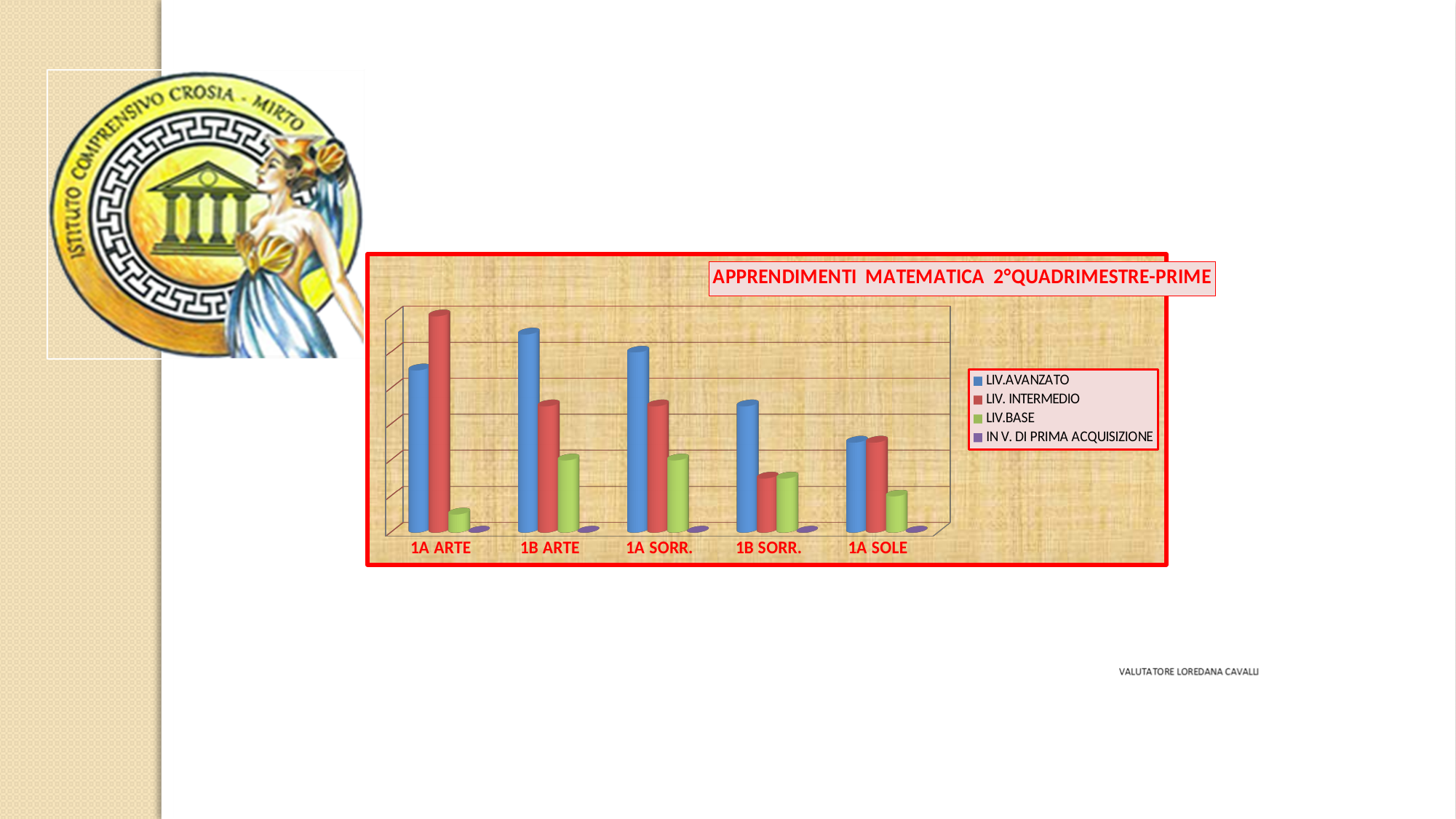
For 1B ARTE, which is larger: LIV.AVANZATO or LIV. INTERMEDIO? LIV.AVANZATO Which class has the shortest LIV.AVANZATO bar? 1A SOLE Which class has the tallest LIV.AVANZATO bar? 1B ARTE What kind of chart is shown on the slide? bar chart Which class has the shortest LIV. INTERMEDIO bar? 1B SORR. What is the title of the chart? APPRENDIMENTI MATEMATICA 2°QUADRIMESTRE-PRIME How many series does the chart legend list? 4 How many categories (classes) are shown on the x axis of the chart? 5 Which class has the shortest LIV.BASE bar? 1A ARTE Which series is shown in green in the chart? LIV.BASE Which class has the tallest LIV. INTERMEDIO bar? 1A ARTE For 1A ARTE, which is larger: LIV.AVANZATO or LIV. INTERMEDIO? LIV. INTERMEDIO